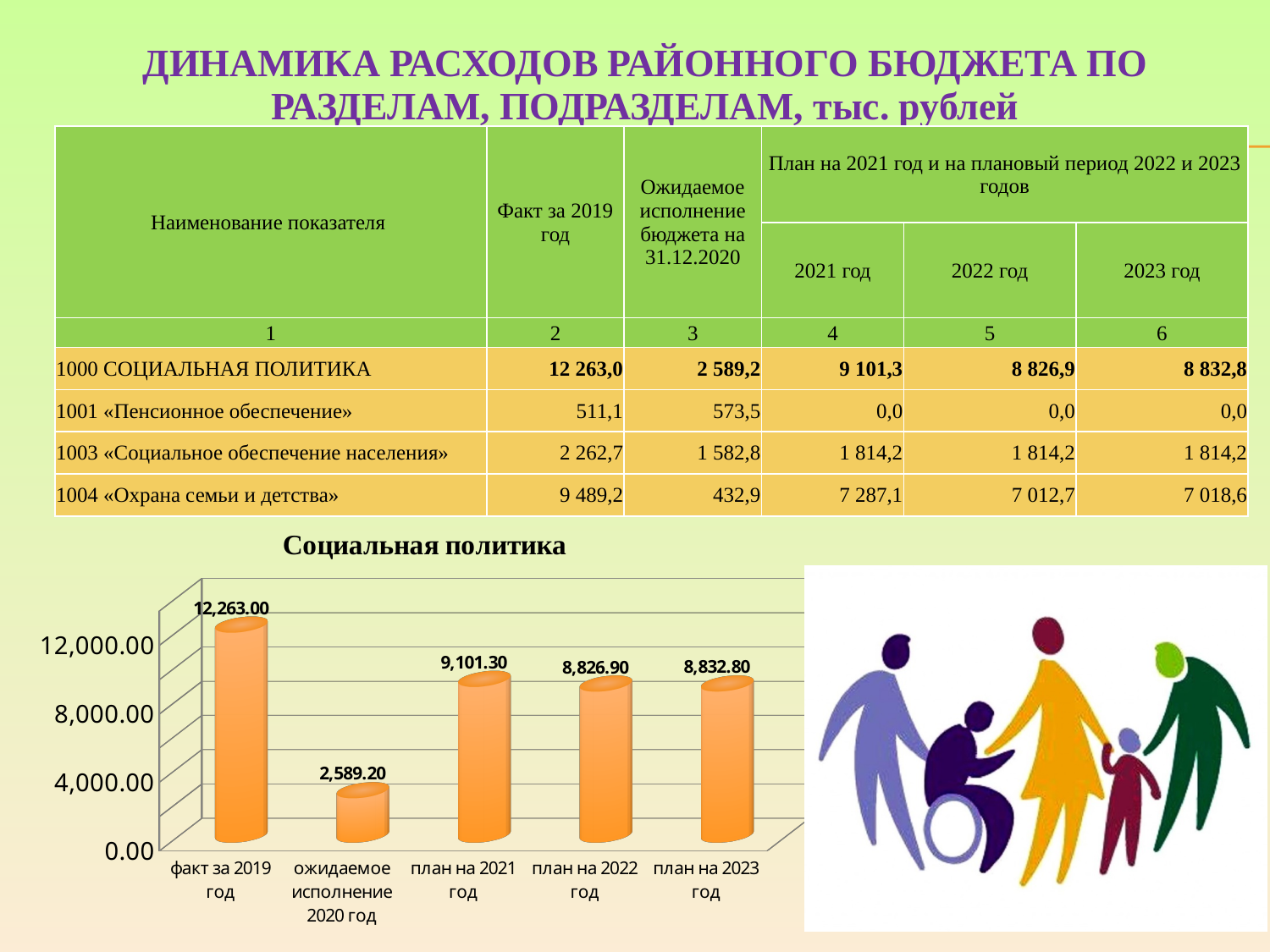
What is the difference between the values for факт за 2019 год and ожидаемое исполнение 2020 год in the Социальная политика chart? 9,673.80 What is the value for ожидаемое исполнение 2020 год in the Социальная политика chart? 2,589.20 What is the value for факт за 2019 год in the Социальная политика chart? 12,263.00 Which category has the lowest value in the Социальная политика chart? ожидаемое исполнение 2020 год What is the difference between the values for план на 2021 год and план на 2022 год in the Социальная политика chart? 274.40 How many bars are shown in the Социальная политика chart? 5 Is the value for ожидаемое исполнение 2020 год in the Социальная политика chart greater or less than 4,000.00? less What is the value for план на 2021 год in the Социальная политика chart? 9,101.30 Which category has the highest value in the Социальная политика chart? факт за 2019 год In the Социальная политика chart, which is larger: the value for план на 2021 год or the value for ожидаемое исполнение 2020 год? план на 2021 год What is the value for план на 2023 год in the Социальная политика chart? 8,832.80 What type of chart is the Социальная политика chart? bar chart